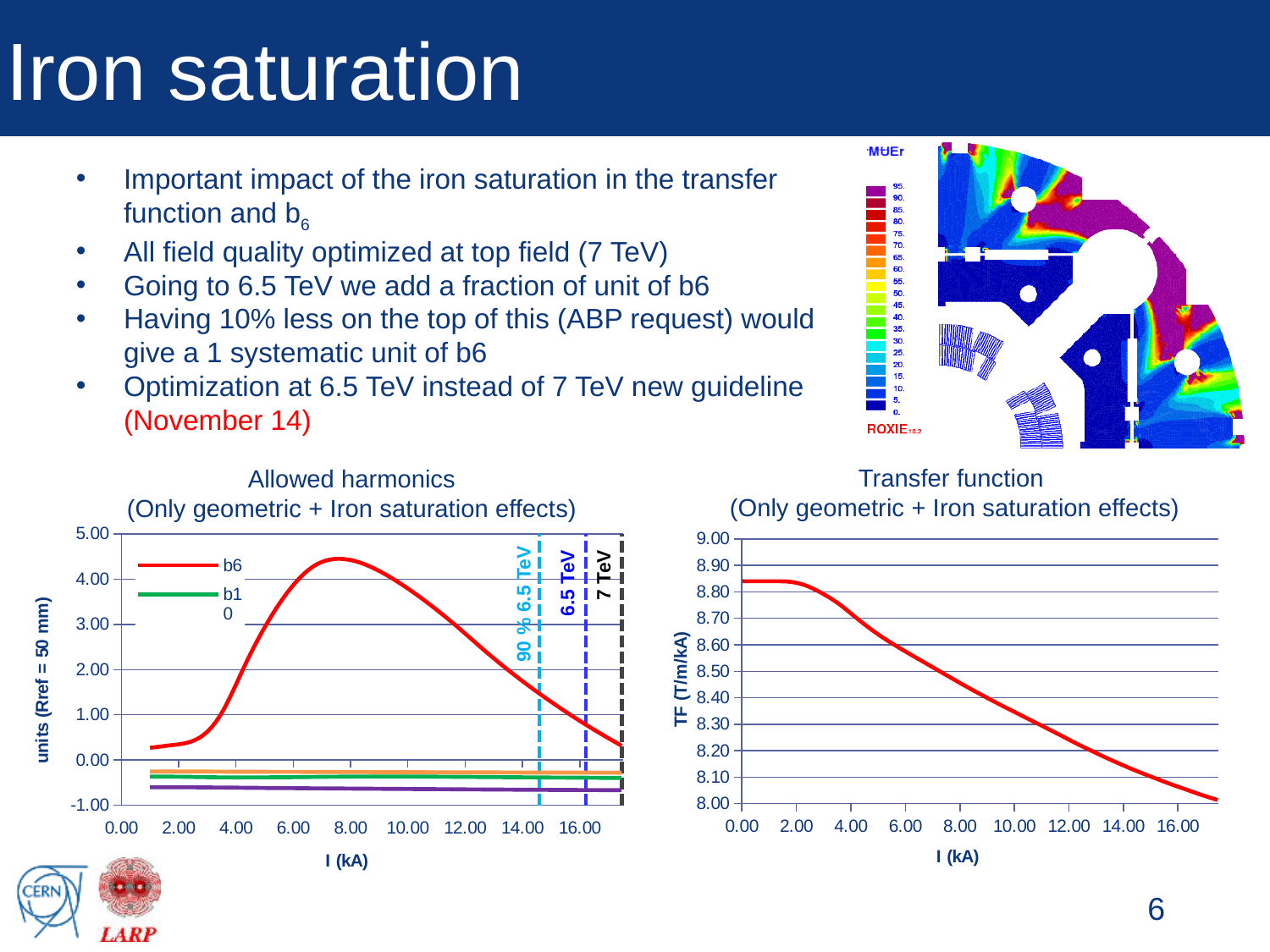
What kind of chart is the 'Allowed harmonics' chart on the left? line chart In the 'Allowed harmonics' chart, is the b6 value at 16.00 kA greater or less than 1.00? less What is the y-axis label of the 'Transfer function' chart? TF (T/m/kA) In the 'Allowed harmonics' chart, is the b6 value at 6.5 TeV greater or less than 2.00? less In the 'Transfer function' chart, does the TF value rise or fall as the current I (kA) increases? fall In the 'Transfer function' chart, is the TF value at 16.00 kA greater or less than 8.10? less In the 'Allowed harmonics' chart, which series is plotted in red? b6 What kind of chart is the 'Transfer function' chart on the right? line chart In the 'Allowed harmonics' chart, how many vertical dashed reference lines are drawn? 3